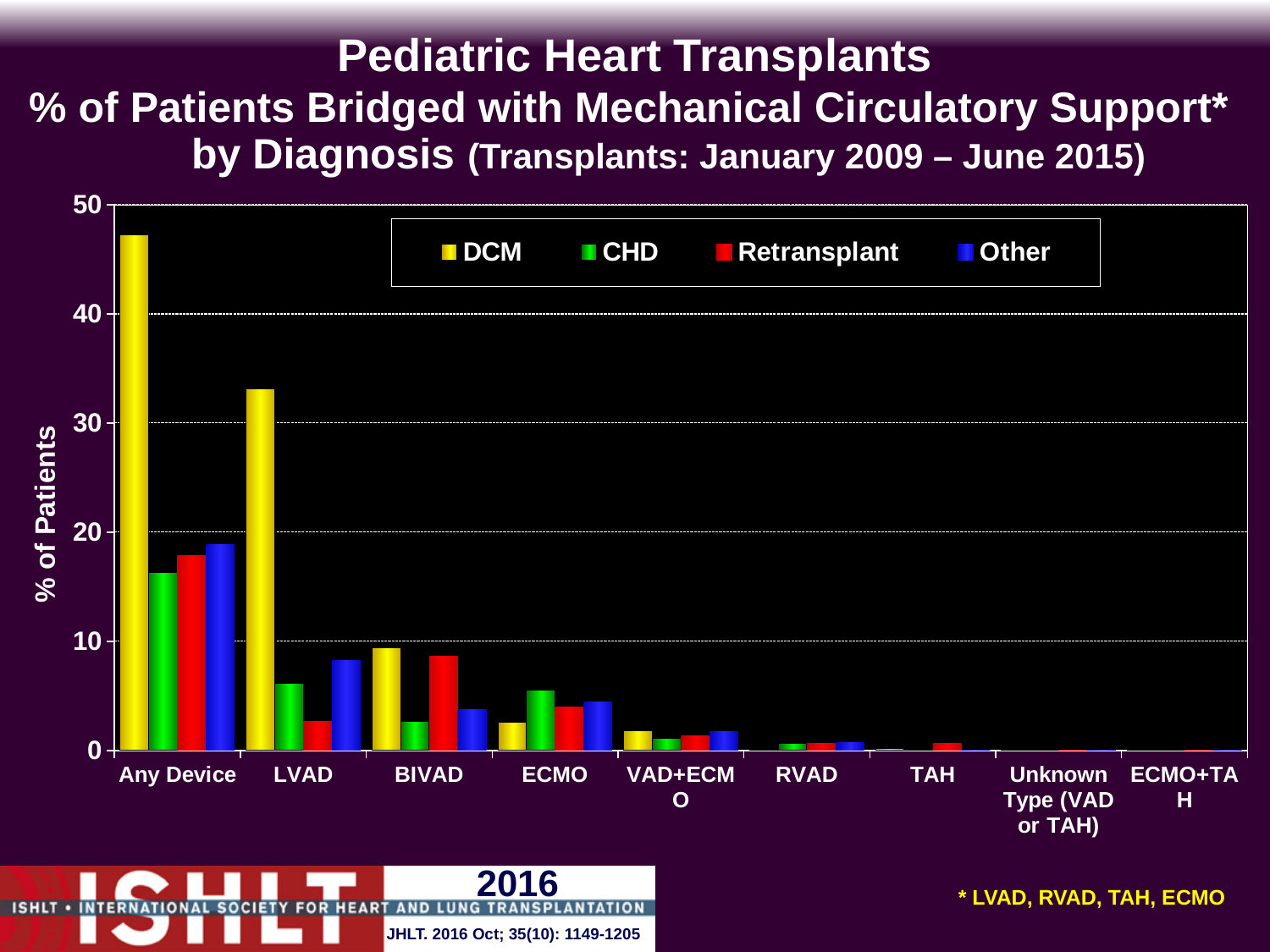
For LVAD, which is larger: the DCM value or the CHD value? DCM What kind of chart is shown on the slide? bar chart Which device category has the highest DCM value? Any Device Is the DCM value for LVAD greater or less than 30? greater Is the Other value for LVAD greater or less than 10? less How many device categories are shown on the x axis? 9 Is the DCM value for Any Device greater or less than 40? greater Which diagnosis has the highest value for Any Device? DCM What is the label of the y axis? % of Patients For ECMO, which is larger: the CHD value or the DCM value? CHD How many series does the legend list? 4